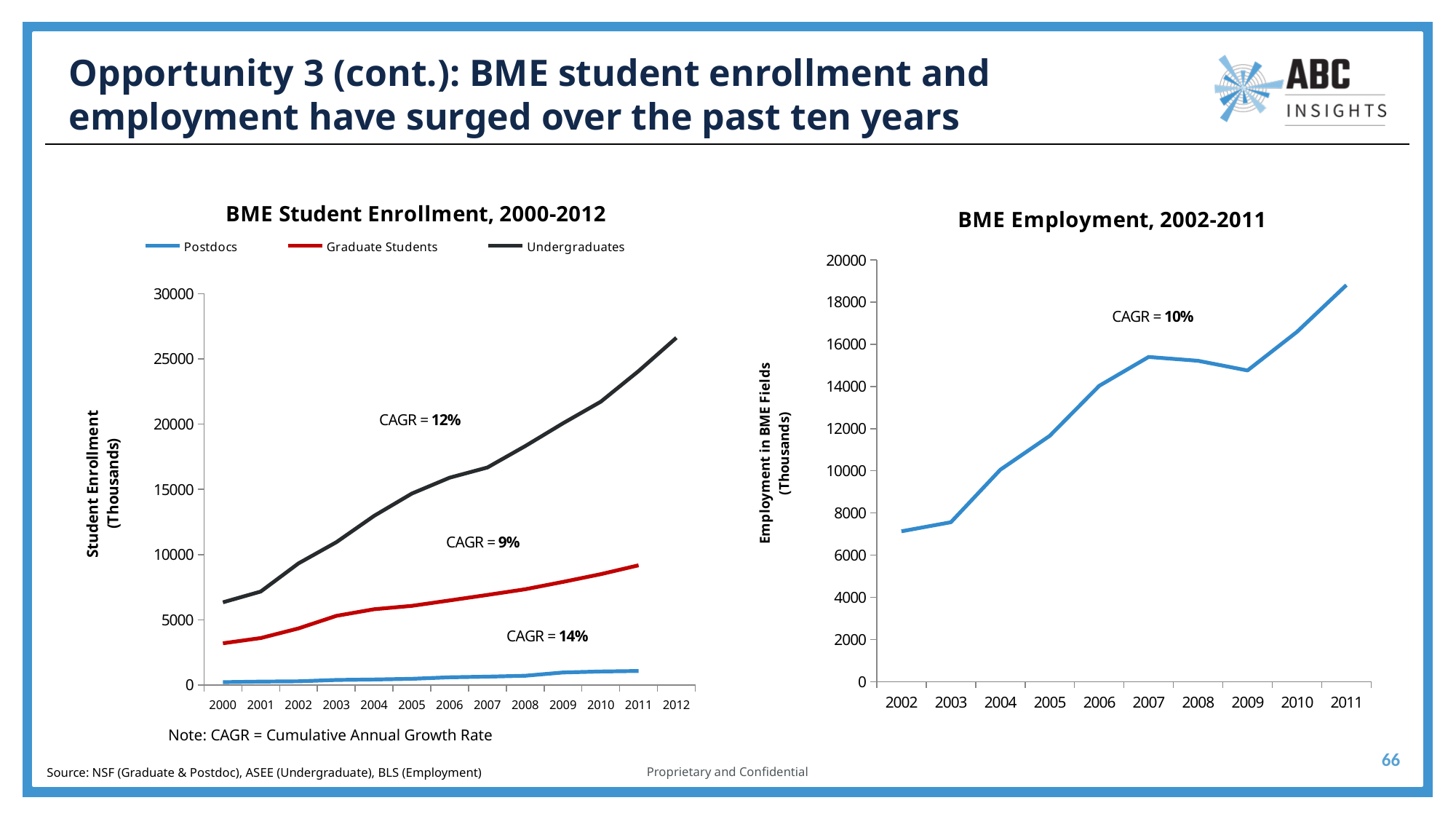
In the BME Student Enrollment, 2000-2012 chart, is the Undergraduates value for 2012 greater or less than 25000? greater In the BME Student Enrollment, 2000-2012 chart, what is the CAGR shown for Undergraduates? 12% In the BME Student Enrollment, 2000-2012 chart, which colour is used for the Graduate Students line? Red What type of chart is the BME Student Enrollment, 2000-2012 chart? Line chart How many series does the legend of the BME Student Enrollment, 2000-2012 chart list? 3 In the BME Employment, 2002-2011 chart, is the value for 2002 greater or less than 8000? less In the BME Student Enrollment, 2000-2012 chart, which series has the highest enrollment in 2010? Undergraduates In the BME Employment, 2002-2011 chart, which year has the highest employment? 2011 In the BME Student Enrollment, 2000-2012 chart, what is the CAGR shown for Postdocs? 14% In the BME Employment, 2002-2011 chart, how many years are plotted on the x axis? 10 In the BME Student Enrollment, 2000-2012 chart, is the Graduate Students value for 2011 greater or less than 10000? less In the BME Employment, 2002-2011 chart, what is the CAGR shown? 10%